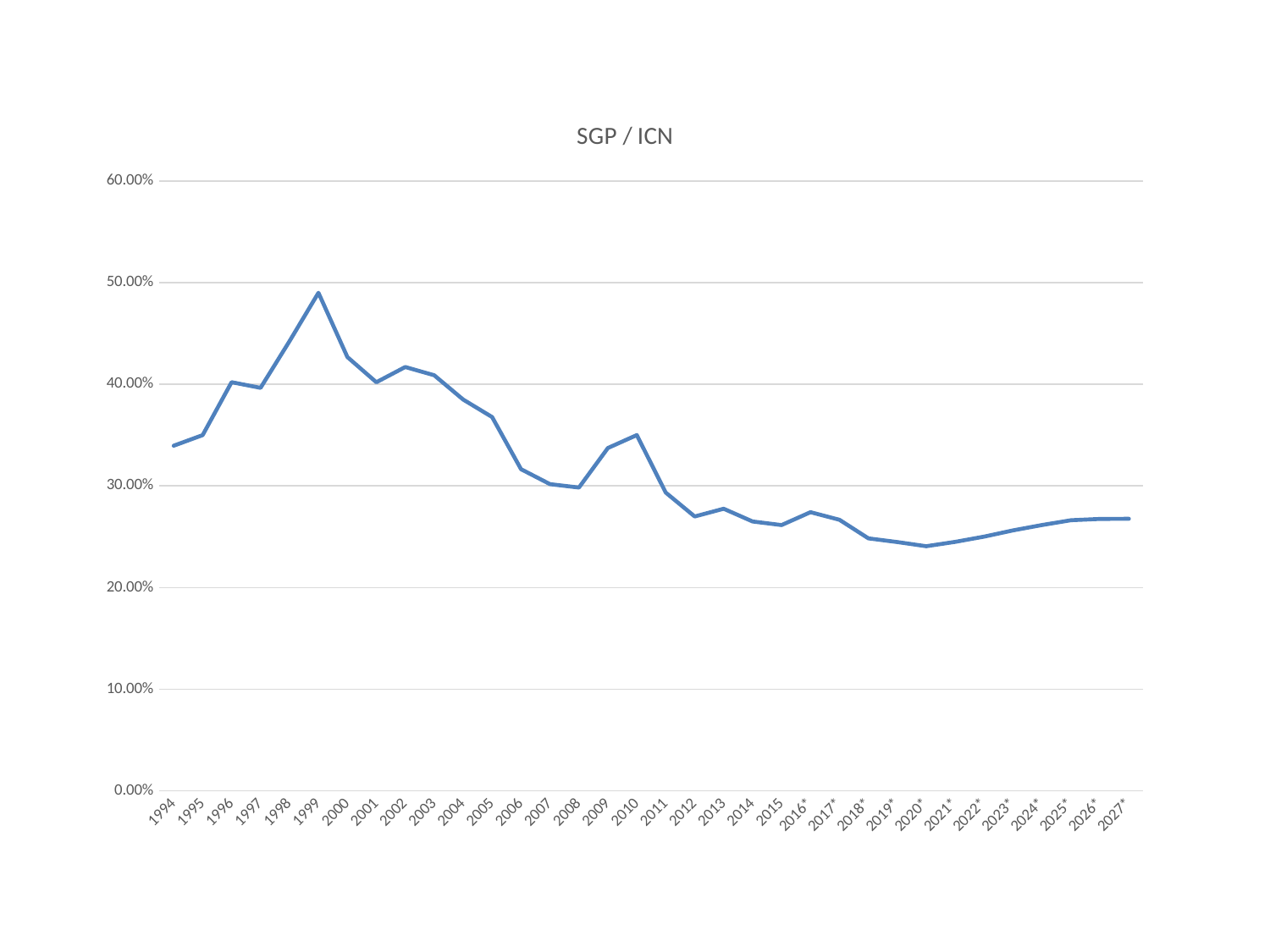
Is the value for 1999 greater or less than 40.00%? greater Overall, do the values rise or fall from 1994 to 2027*? fall What kind of chart is shown on the slide? line chart Which is larger, the value for 1999 or the value for 2010? 1999 Which is larger, the value for 2010 or the value for 2020*? 2010 How many years are plotted along the x axis? 34 What is the title of the chart? SGP / ICN Is the value for 1994 greater or less than 40.00%? less Is the value for 2005 greater or less than 30.00%? greater Which year has the highest value on the chart? 1999